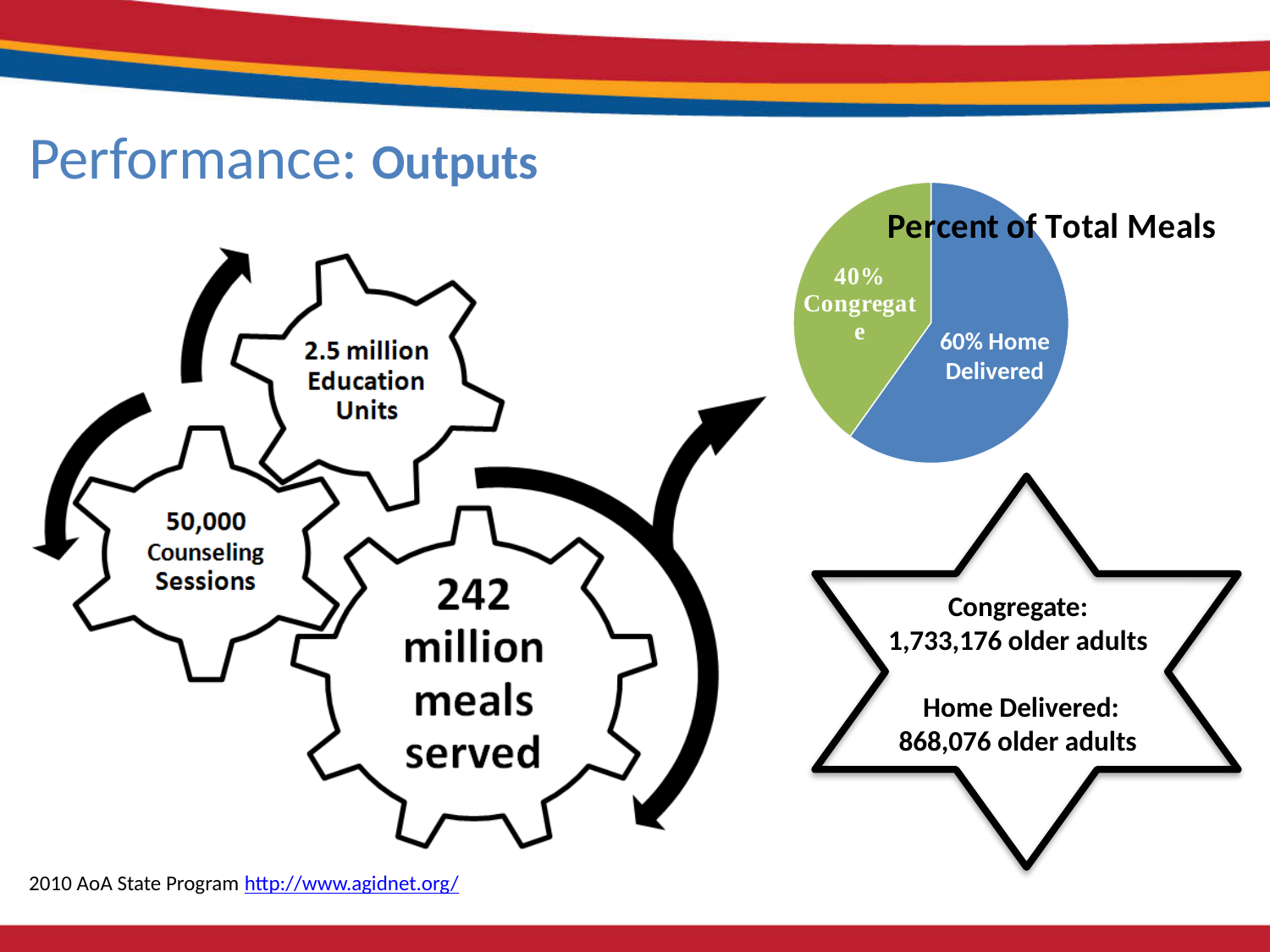
Which is larger, the Congregate slice or the Home Delivered slice? Home Delivered What is the title of the pie chart? Percent of Total Meals How many slices does the pie chart have? 2 Which slice of the pie chart is the largest? Home Delivered What percentage of total meals is Congregate? 40% What kind of chart is shown on the slide? pie chart What colour is the Congregate slice of the pie chart? green What percentage of total meals is Home Delivered? 60% Which slice of the pie chart is the smallest? Congregate What is the difference in percentage points between the Home Delivered and Congregate slices? 20% What share of the pie does the Home Delivered slice represent? 60%